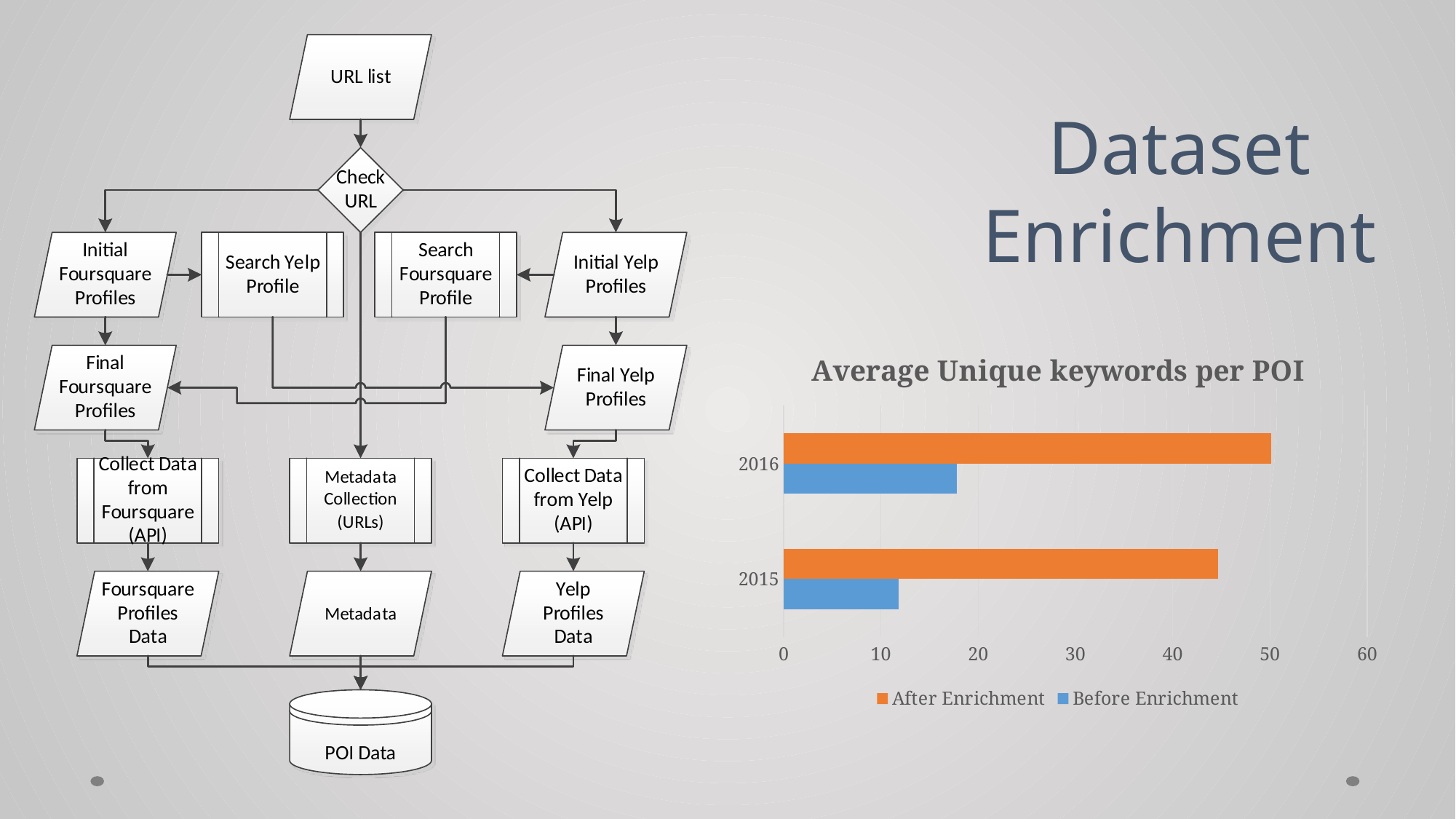
How many series does the chart legend list? 2 In 2015, which is larger: After Enrichment or Before Enrichment? After Enrichment What is the title of the chart on the slide? Average Unique keywords per POI Which year has the higher After Enrichment value? 2016 Is the After Enrichment value for 2016 greater or less than 40? greater What type of chart is shown on the slide? bar chart Is the Before Enrichment value for 2016 greater or less than 20? less How many categories (years) are shown on the chart? 2 Is the After Enrichment value for 2015 greater or less than 50? less Which colour represents the After Enrichment series in the chart? orange Which year has the lower Before Enrichment value? 2015